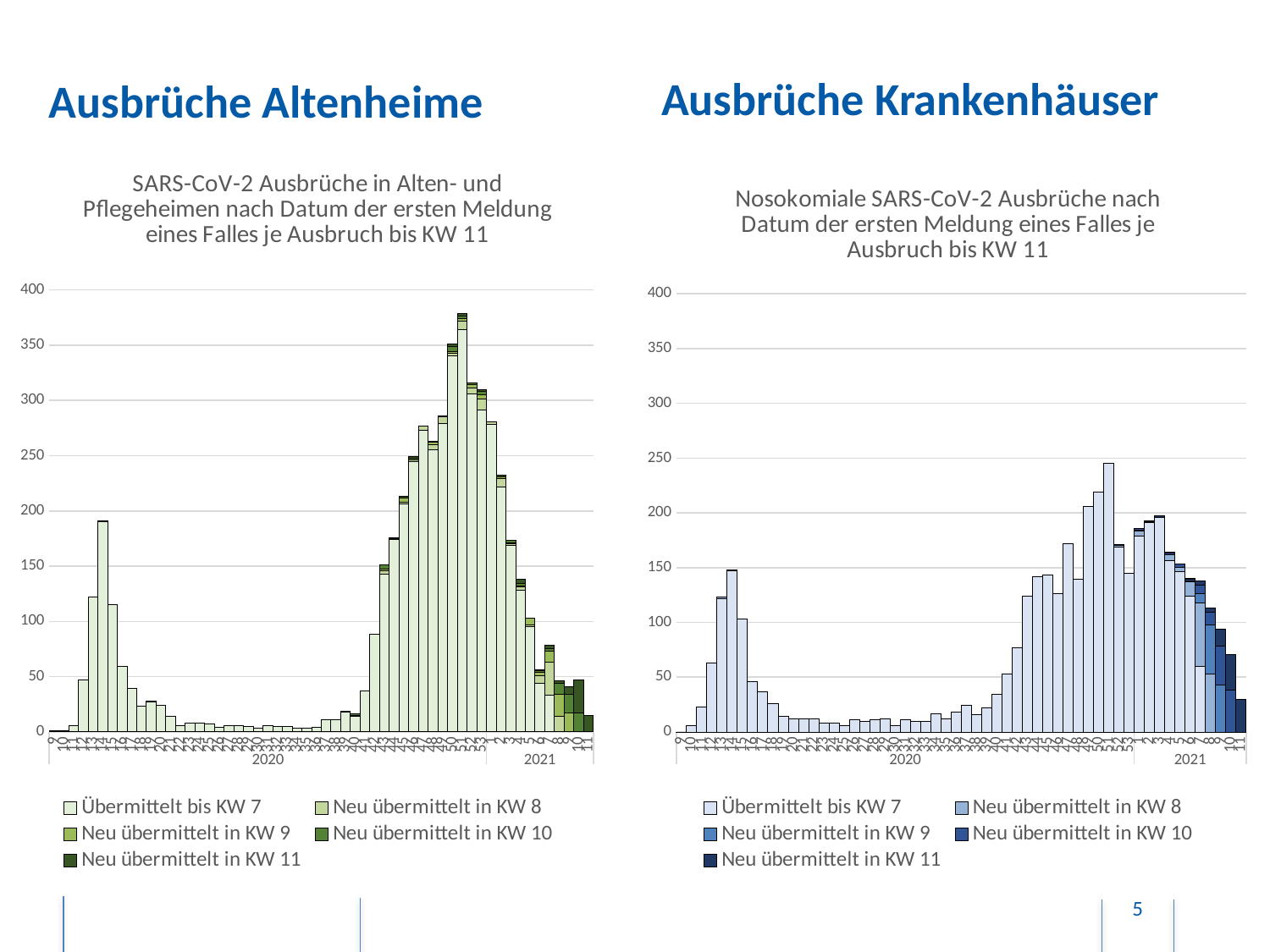
In the right chart (Krankenhäuser), is the value of the tallest bar greater or less than 200? greater In the left chart (Altenheime), is the tallest bar of the first wave in spring 2020 greater or less than 150? greater What kind of chart is the right chart, 'Nosokomiale SARS-CoV-2 Ausbrüche'? Stacked bar chart Which legend entry in the right chart (Krankenhäuser) is shown in the darkest blue? Neu übermittelt in KW 11 What is the title of the left chart? SARS-CoV-2 Ausbrüche in Alten- und Pflegeheimen nach Datum der ersten Meldung eines Falles je Ausbruch bis KW 11 In the left chart (Altenheime), is the value of the tallest bar greater or less than 350? greater How many series does the legend of the left chart (Altenheime) list? 5 In the left chart (Altenheime), do the bar values rise or fall from the peak in late 2020 to the last weeks of 2021 shown? fall How many series does the legend of the right chart (Krankenhäuser) list? 5 What kind of chart is the left chart, 'SARS-CoV-2 Ausbrüche in Alten- und Pflegeheimen'? Stacked bar chart Which chart has the higher peak bar, the left chart (Altenheime) or the right chart (Krankenhäuser)? The left chart (Altenheime)